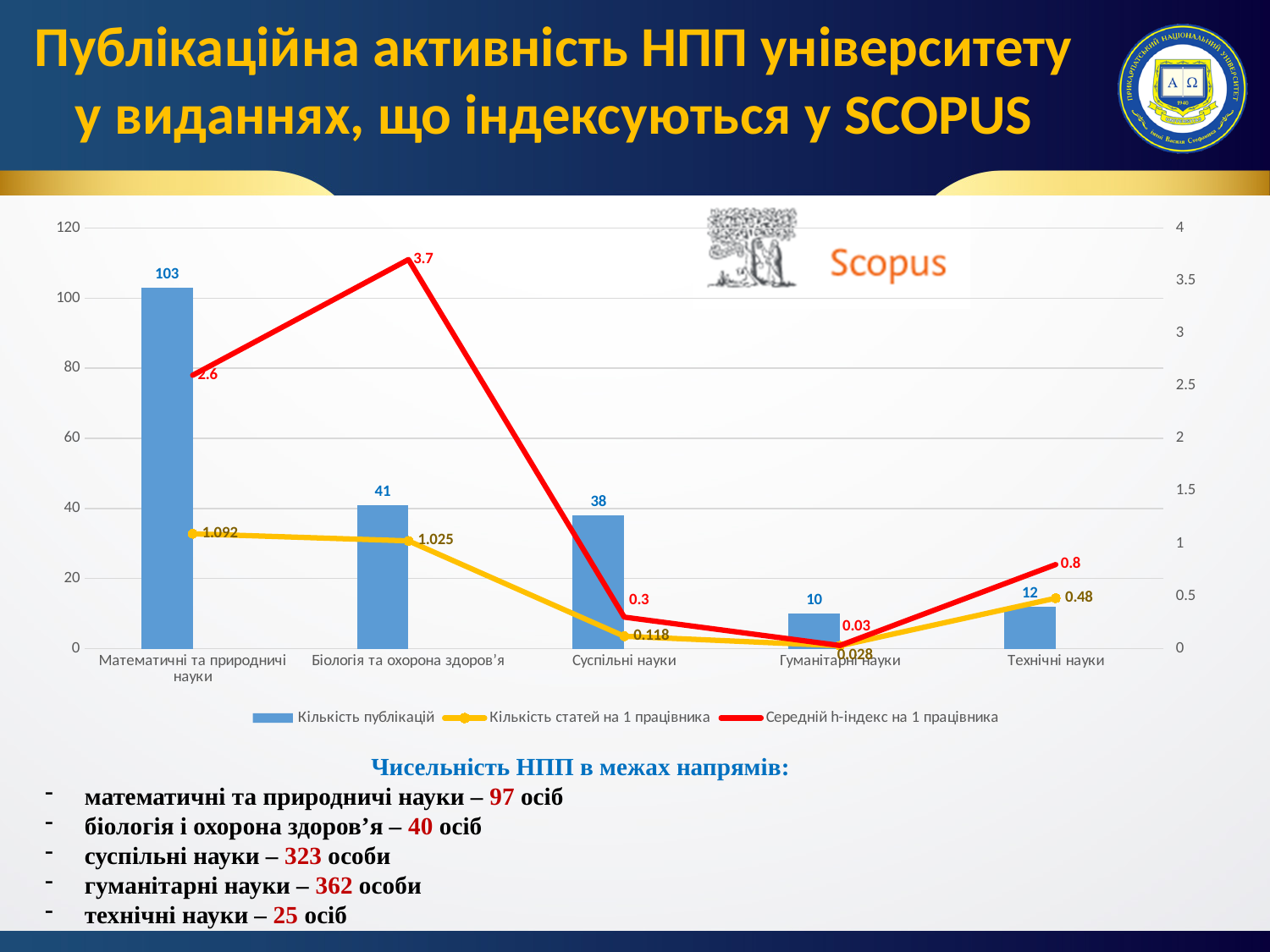
What is the difference in number of publications between Біологія та охорона здоров'я and Суспільні науки? 3 What is the number of publications (Кількість публікацій) for Математичні та природничі науки? 103 What colour is the line for Середній h-індекс на 1 працівника? Red What is the number of articles per employee (Кількість статей на 1 працівника) for Технічні науки? 0.48 Which category has the highest number of publications? Математичні та природничі науки Which has a higher average h-index per employee: Математичні та природничі науки or Біологія та охорона здоров'я? Біологія та охорона здоров'я How many categories are shown on the x axis of the chart? 5 What is the number of publications for Гуманітарні науки? 10 How many series does the chart legend list? 3 What is the average h-index per employee (Середній h-індекс на 1 працівника) for Біологія та охорона здоров'я? 3.7 Which category has the lowest average h-index per employee? Гуманітарні науки Which series is drawn as bars in the chart? Кількість публікацій